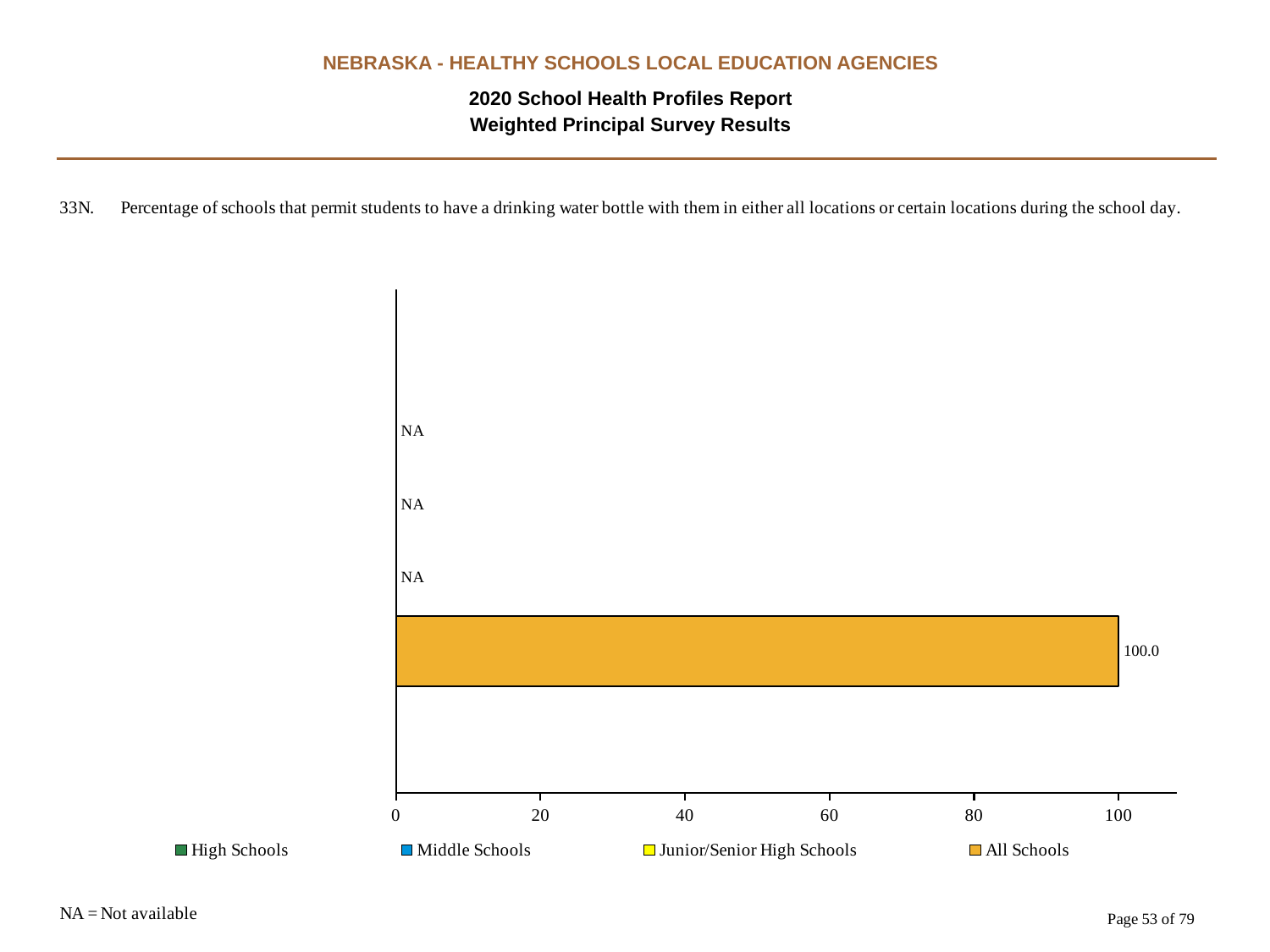
Which series has a plotted bar with a numeric value? All Schools What is the value for All Schools? 100.0 What is shown for Middle Schools instead of a value? NA What is the highest tick value shown on the x axis? 100 How many series are marked NA on the chart? 3 What does NA stand for according to the note on the slide? Not available How many series does the legend list? 4 What is shown for High Schools instead of a value? NA What kind of chart is shown on the slide? bar chart What is shown for Junior/Senior High Schools instead of a value? NA Is the value for All Schools greater or less than 80? greater